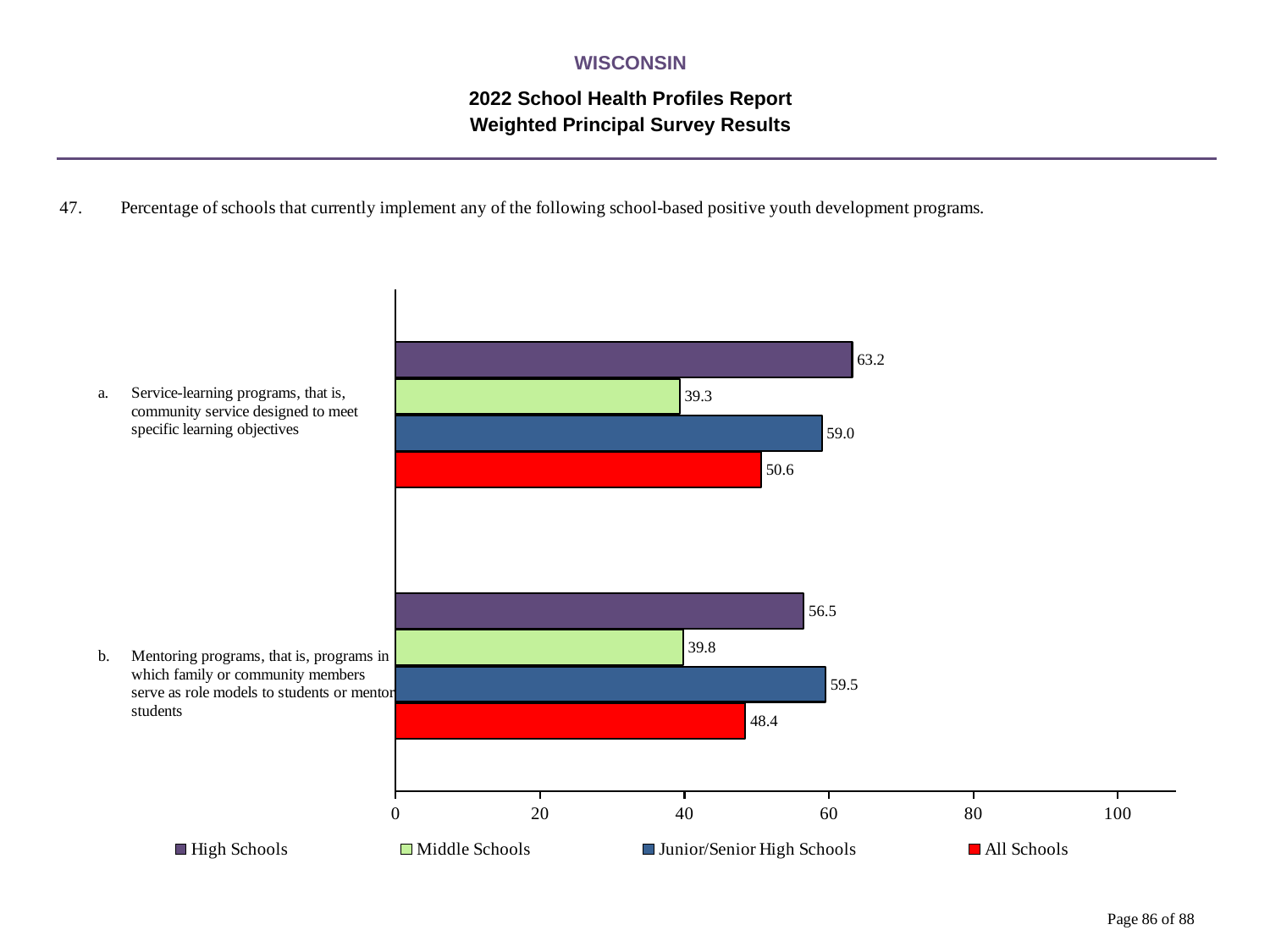
What kind of chart is shown on the slide? bar chart Which is larger for mentoring programs (item b): the High Schools value or the Junior/Senior High Schools value? Junior/Senior High Schools Is the All Schools value for mentoring programs (item b) greater or less than 60? less What colour are the All Schools bars? red How many series does the legend list? 4 Which school type has the lowest value for mentoring programs (item b)? Middle Schools What is the value for Junior/Senior High Schools for mentoring programs (item b)? 59.5 What is the value for All Schools for service-learning programs (item a)? 50.6 What is the value for High Schools for service-learning programs (item a)? 63.2 Which school type has the highest value for service-learning programs (item a)? High Schools What is the difference between the High Schools value and the Middle Schools value for service-learning programs (item a)? 23.9 What is the value for Middle Schools for mentoring programs (item b)? 39.8